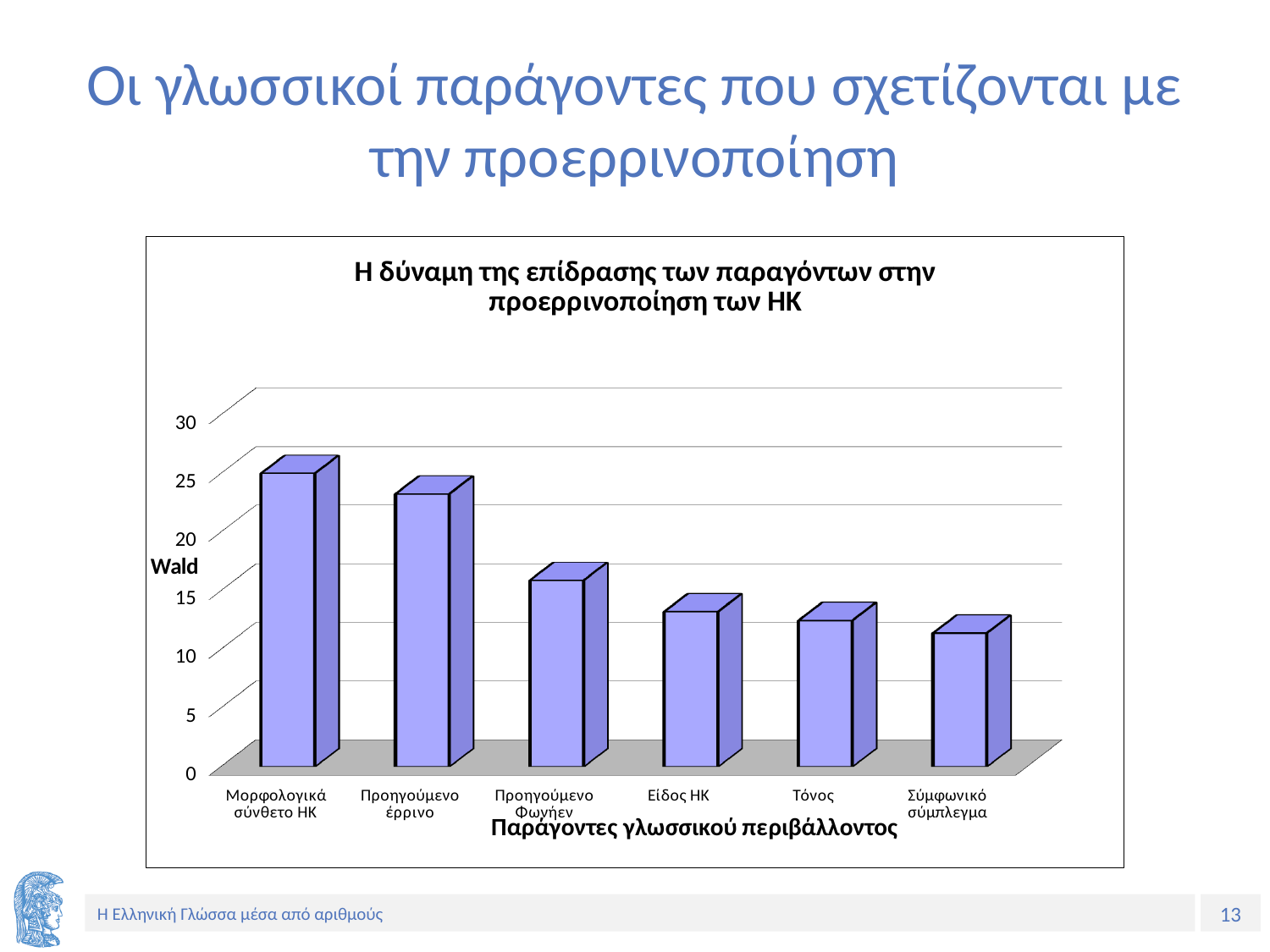
Which is larger, the Wald value for Προηγούμενο έρρινο or for Προηγούμενο Φωνήεν? Προηγούμενο έρρινο Is the Wald value for Μορφολογικά σύνθετο ΗΚ greater or less than 20? greater Which factor has the highest Wald value? Μορφολογικά σύνθετο ΗΚ Is the Wald value for Σύμφωνικό σύμπλεγμα greater or less than 15? less Is the Wald value for Προηγούμενο έρρινο greater or less than 20? greater What is the label of the vertical axis? Wald How many categories (factors) are plotted on the x axis? 6 What is the title of the chart? Η δύναμη της επίδρασης των παραγόντων στην προερρινοποίηση των ΗΚ Do the Wald values rise or fall moving from left to right along the x axis? fall Which is larger, the Wald value for Μορφολογικά σύνθετο ΗΚ or for Είδος ΗΚ? Μορφολογικά σύνθετο ΗΚ What kind of chart is shown on the slide? bar chart